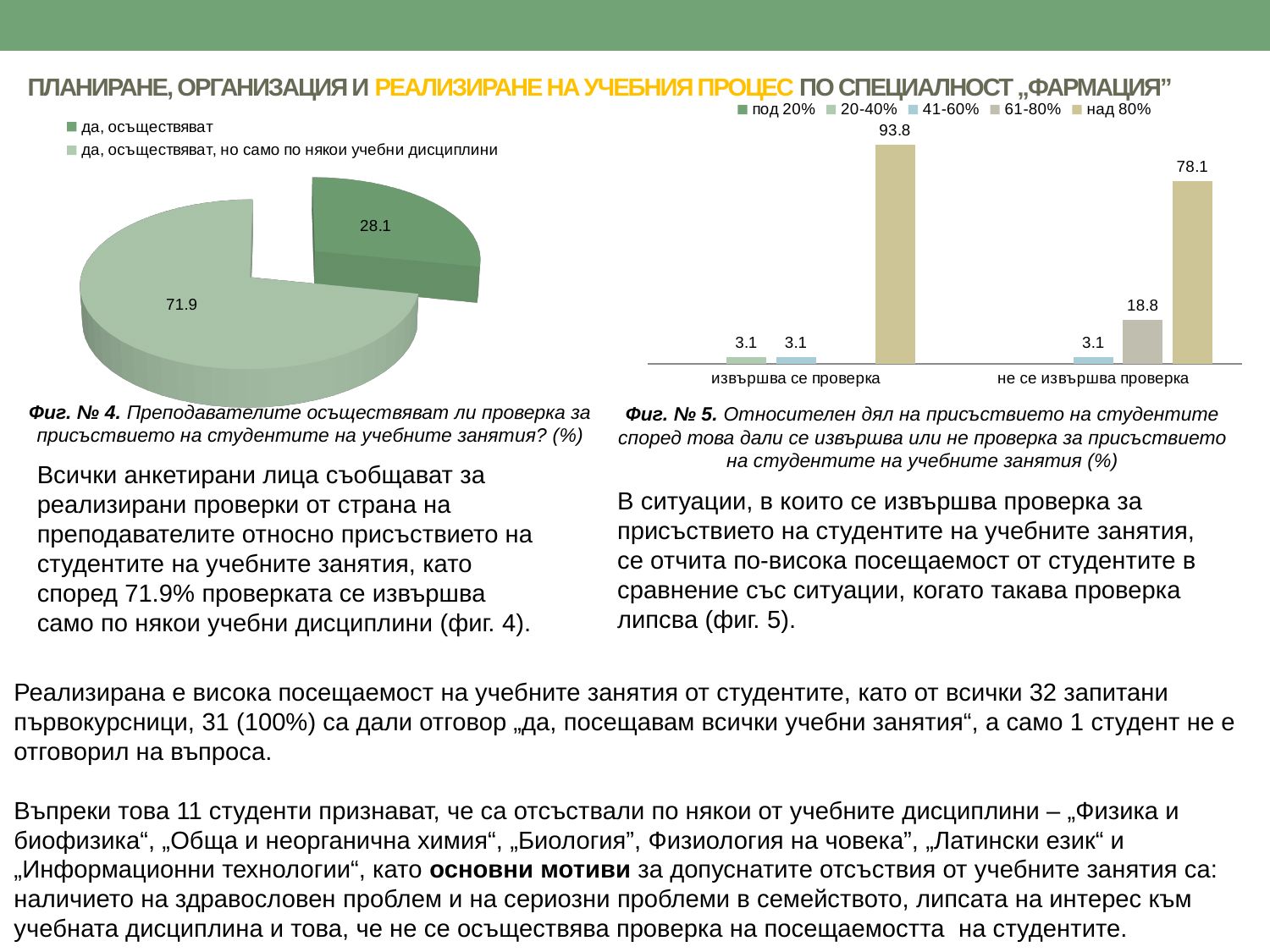
What kind of chart is Фиг. № 5? bar chart In the bar chart (Фиг. № 5), what is the difference between the "над 80%" values for "извършва се проверка" and "не се извършва проверка"? 15.7 In the bar chart (Фиг. № 5), what is the value for "над 80%" in the "извършва се проверка" category? 93.8 In the pie chart (Фиг. № 4), what is the value for "да, осъществяват"? 28.1 In the bar chart (Фиг. № 5), which category has the higher value for "над 80%": "извършва се проверка" or "не се извършва проверка"? извършва се проверка What kind of chart is Фиг. № 4? pie chart In the bar chart (Фиг. № 5), how many series does the legend list? 5 In the pie chart (Фиг. № 4), which slice is the largest? да, осъществяват, но само по някои учебни дисциплини In the pie chart (Фиг. № 4), what is the value for "да, осъществяват, но само по някои учебни дисциплини"? 71.9 In the bar chart (Фиг. № 5), what is the value for "61-80%" in the "не се извършва проверка" category? 18.8 In the bar chart (Фиг. № 5), what is the value for "над 80%" in the "не се извършва проверка" category? 78.1 In the pie chart (Фиг. № 4), what is the difference between the two slices? 43.8